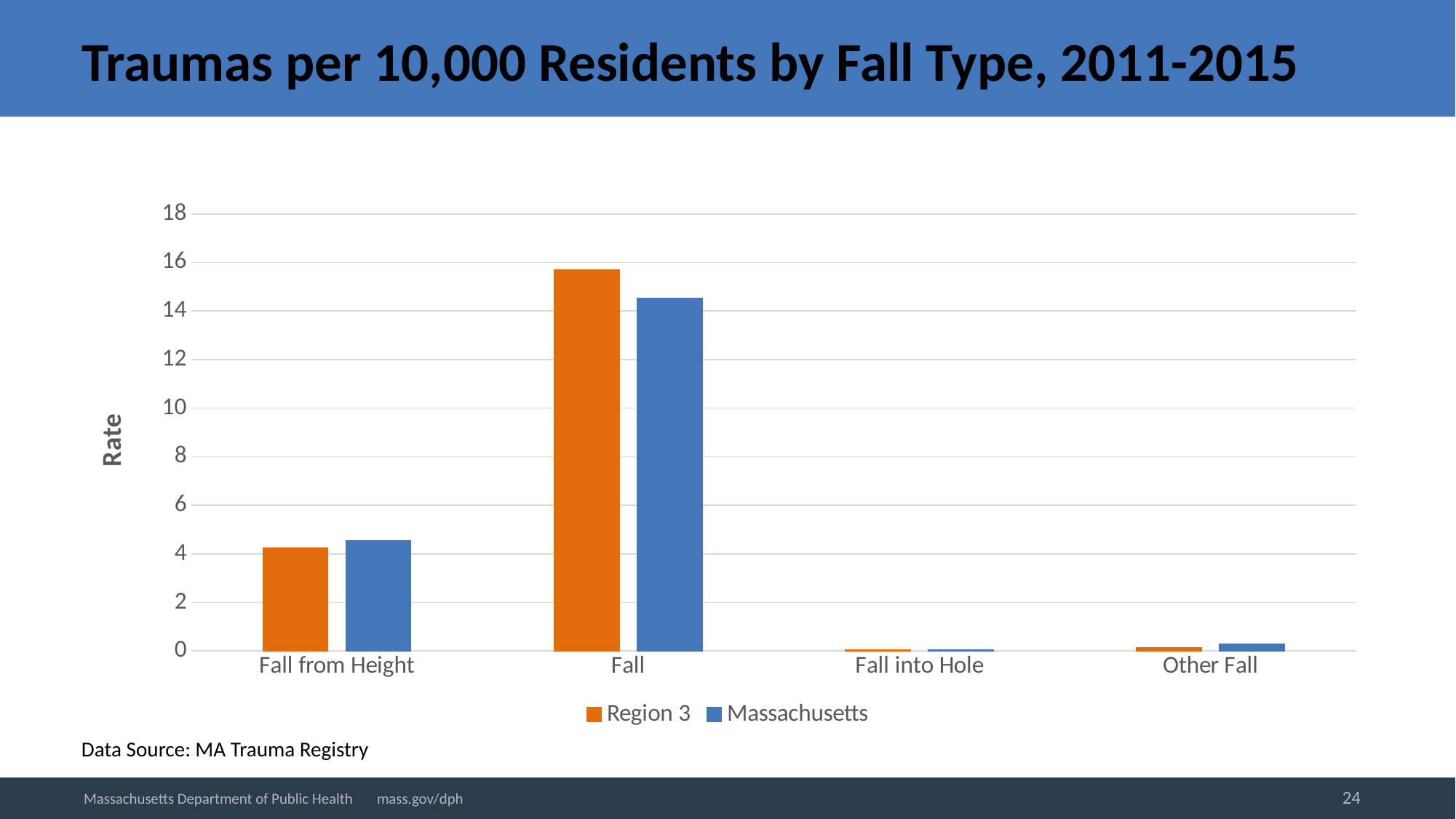
Which fall type has the lowest rate for Massachusetts? Fall into Hole What kind of chart is shown on the slide? bar chart For the Fall category, which is larger: the Region 3 rate or the Massachusetts rate? Region 3 How many series does the legend list? 2 Is the Region 3 rate for Fall greater or less than 14? greater Which fall type has the highest rate for Region 3? Fall Which fall type has the highest rate for Massachusetts? Fall What is the label on the vertical axis? Rate How many fall type categories are shown on the x axis? 4 For Fall from Height, which is larger: the Region 3 rate or the Massachusetts rate? Massachusetts Is the Massachusetts rate for Fall from Height greater or less than 4? greater Is the Massachusetts rate for Fall greater or less than 16? less